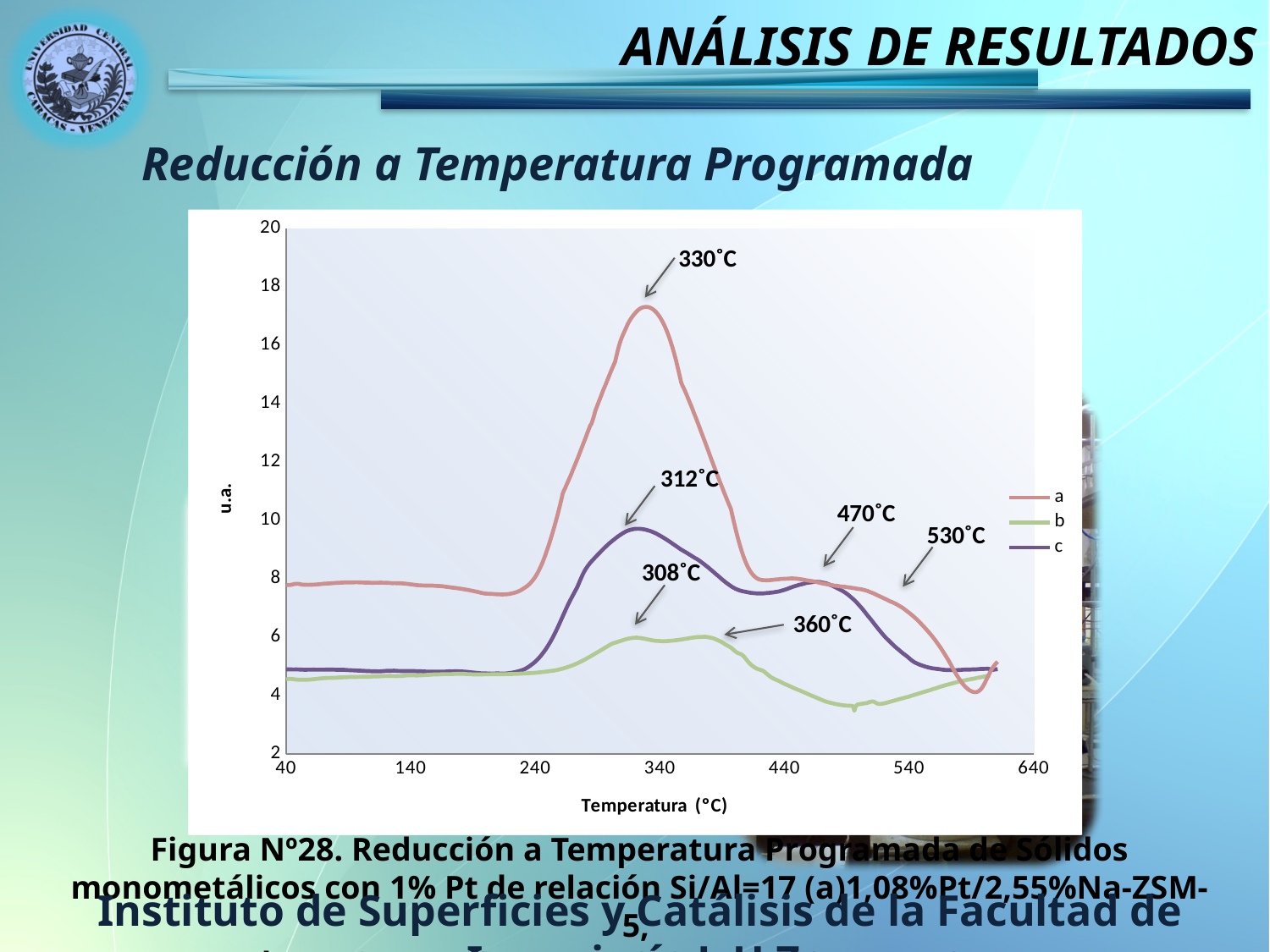
Is the peak value of series a greater or less than 16? greater At what temperature is the first peak of series b annotated? 308˚C At what temperature is the peak of series c annotated? 312˚C What is the label of the x axis? Temperatura (°C) At what temperature is the main peak of series a annotated? 330˚C Is the peak value of series c greater or less than 8? greater Which series has the lowest peak value? b How many series does the legend list? 3 Is the peak value of series b greater or less than 8? less What kind of chart is shown on the slide? line chart Which series reaches the highest peak value? a What are the legend entries of the chart? a, b, c